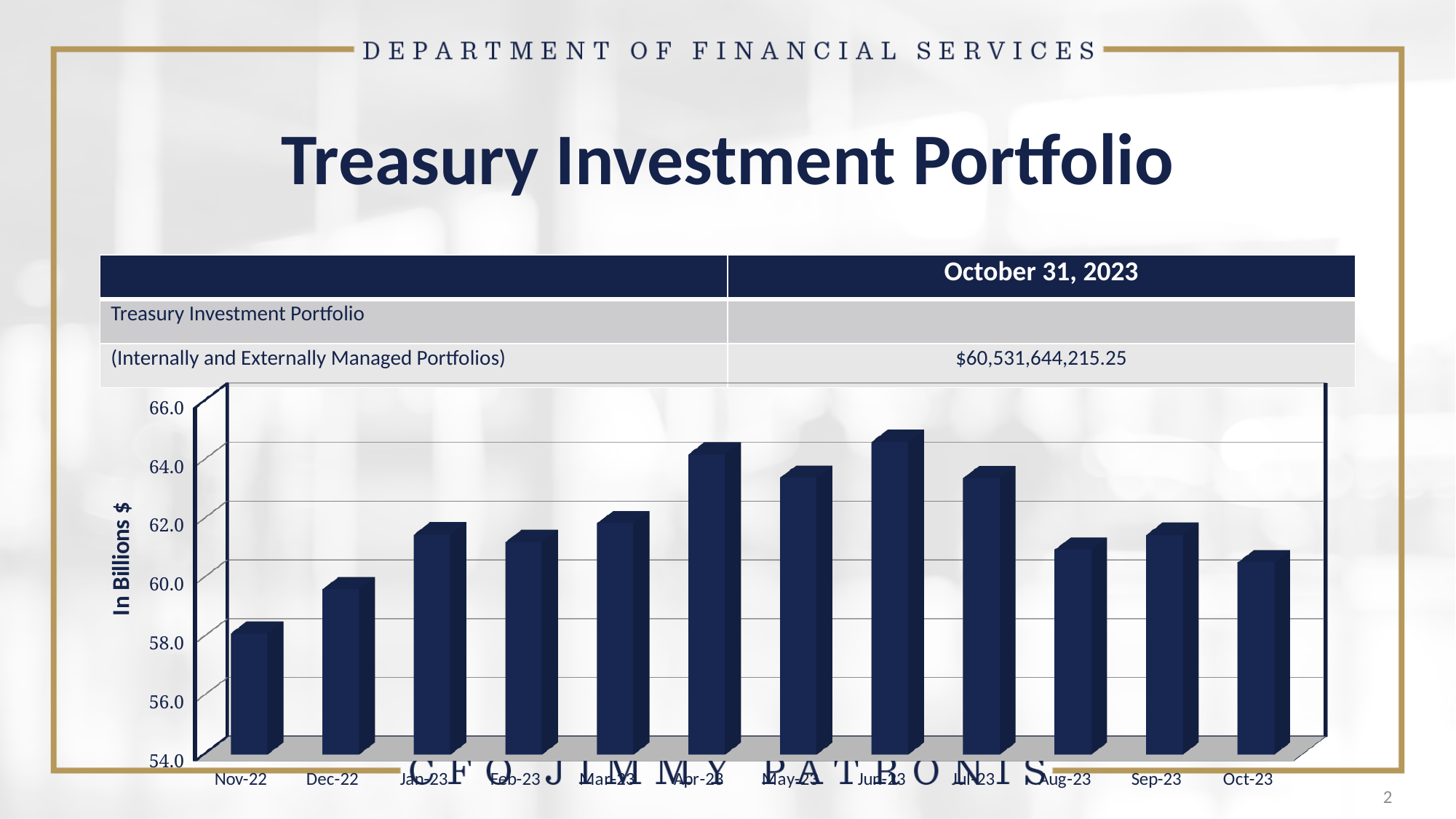
Is the value for Oct-23 greater or less than 62.0? less Which month has the lowest bar in the chart? Nov-22 What kind of chart is shown on the slide? bar chart Is the value for Apr-23 greater or less than 62.0? greater Which is larger, the value for Nov-22 or the value for Dec-22? Dec-22 Is the value for Nov-22 greater or less than 60.0? less Which is larger, the value for Apr-23 or the value for Mar-23? Apr-23 How many months are plotted on the x axis of the chart? 12 Do the values rise or fall from Nov-22 to Apr-23? rise What is the label on the vertical axis of the chart? In Billions $ Which month has the highest bar in the chart? Jun-23